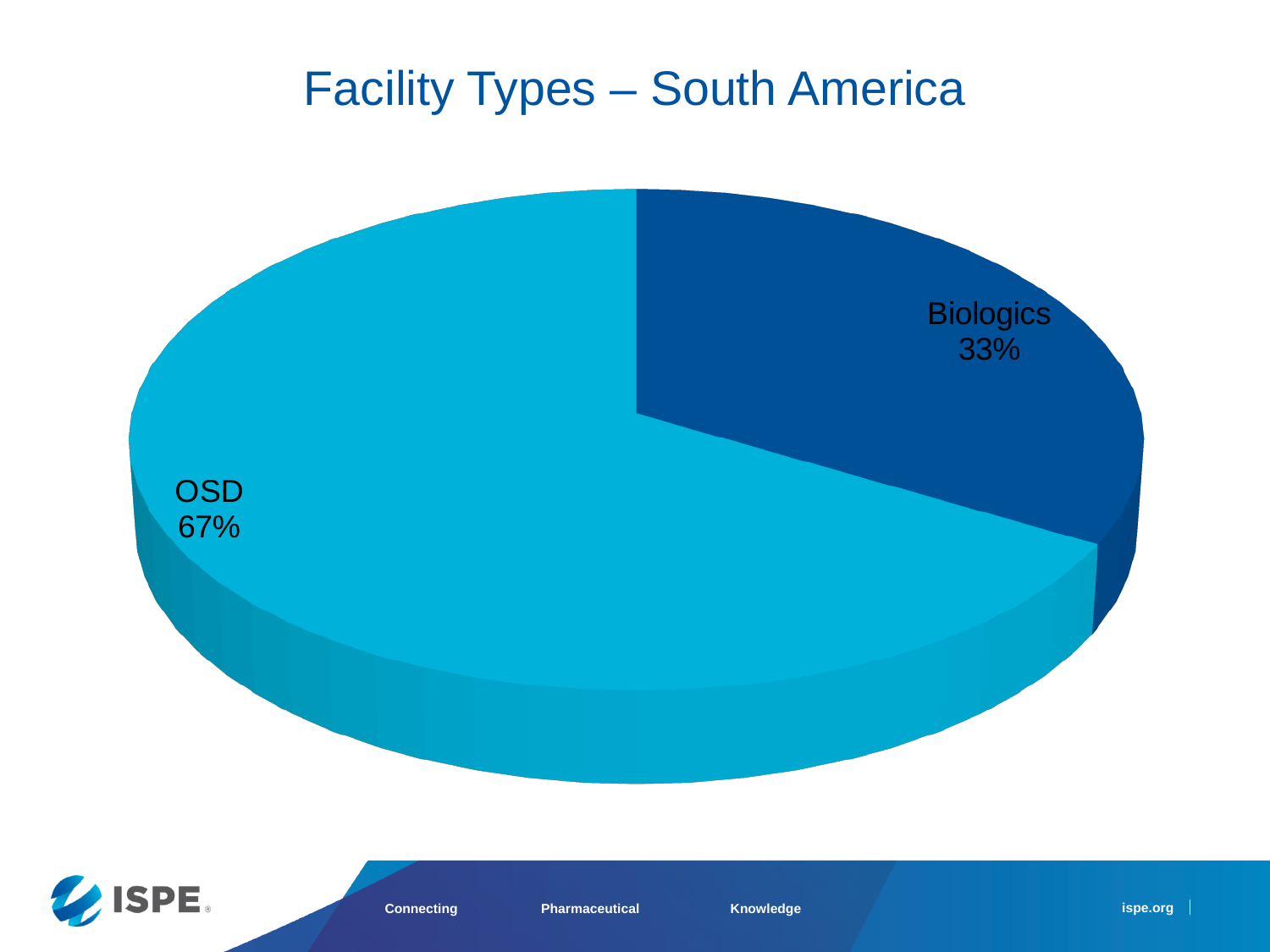
Which facility type has the largest share of the pie? OSD What is the difference in percentage points between the OSD and Biologics shares? 34 Is the share for Biologics greater or less than 50%? less What kind of chart is shown on the slide? Pie chart Which facility type has the smallest share of the pie? Biologics What share of the pie does OSD represent? 67% What is the title of the chart? Facility Types – South America Which is larger, the share for OSD or the share for Biologics? OSD What share of the pie does Biologics represent? 33% Is the share for OSD greater or less than 50%? greater How many slices does the pie chart have? 2 Which slice is shown in the darker blue colour? Biologics